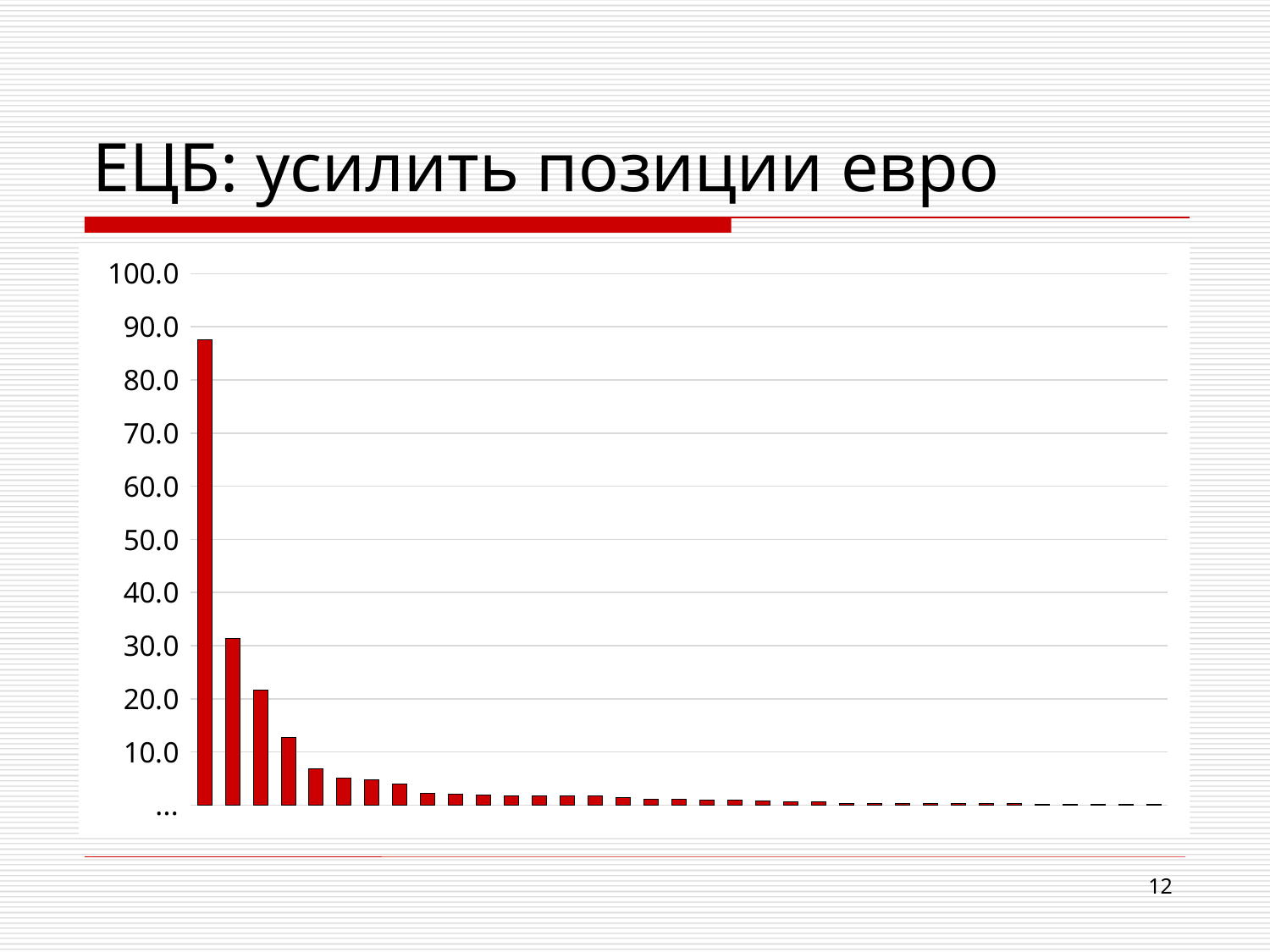
What colour are the bars in the chart? red Is the value of the second bar from the left greater or less than 40.0? less What is the highest value shown on the vertical axis? 100.0 What kind of chart is shown on the slide? bar chart Is the value of the fifth bar from the left greater or less than 10.0? less Is the value of the third bar from the left greater or less than 30.0? less Which is larger, the first bar or the second bar from the left? the first bar Which bar is the highest in the chart? the leftmost (first) bar Do the bar values rise or fall from left to right along the x axis? fall